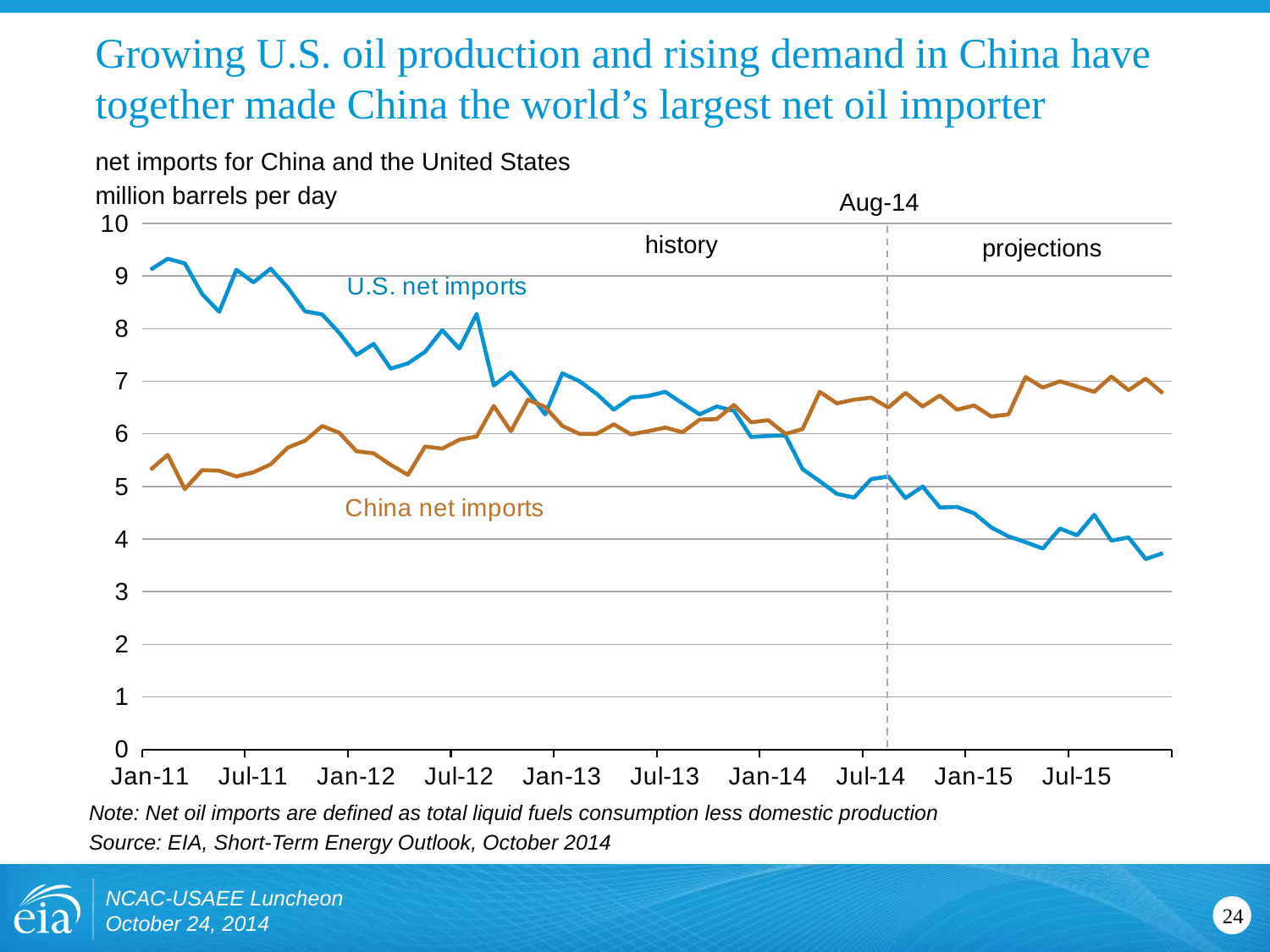
Is the value for China net imports at Jul-15 greater or less than 6? greater Is the value for U.S. net imports at Jan-11 greater or less than 8? greater How many series are plotted on the chart? 2 Is the value for China net imports at Jan-11 greater or less than 6? less What kind of chart is shown on the slide? line chart What date does the dashed vertical line on the chart mark? Aug-14 Do China net imports rise or fall over the period shown on the chart? rise At Jul-15, which series has the higher net imports, U.S. or China? China net imports At Jan-11, which series has the higher net imports, U.S. or China? U.S. net imports What unit is the y axis of the chart measured in? million barrels per day Do U.S. net imports rise or fall over the period shown on the chart? fall